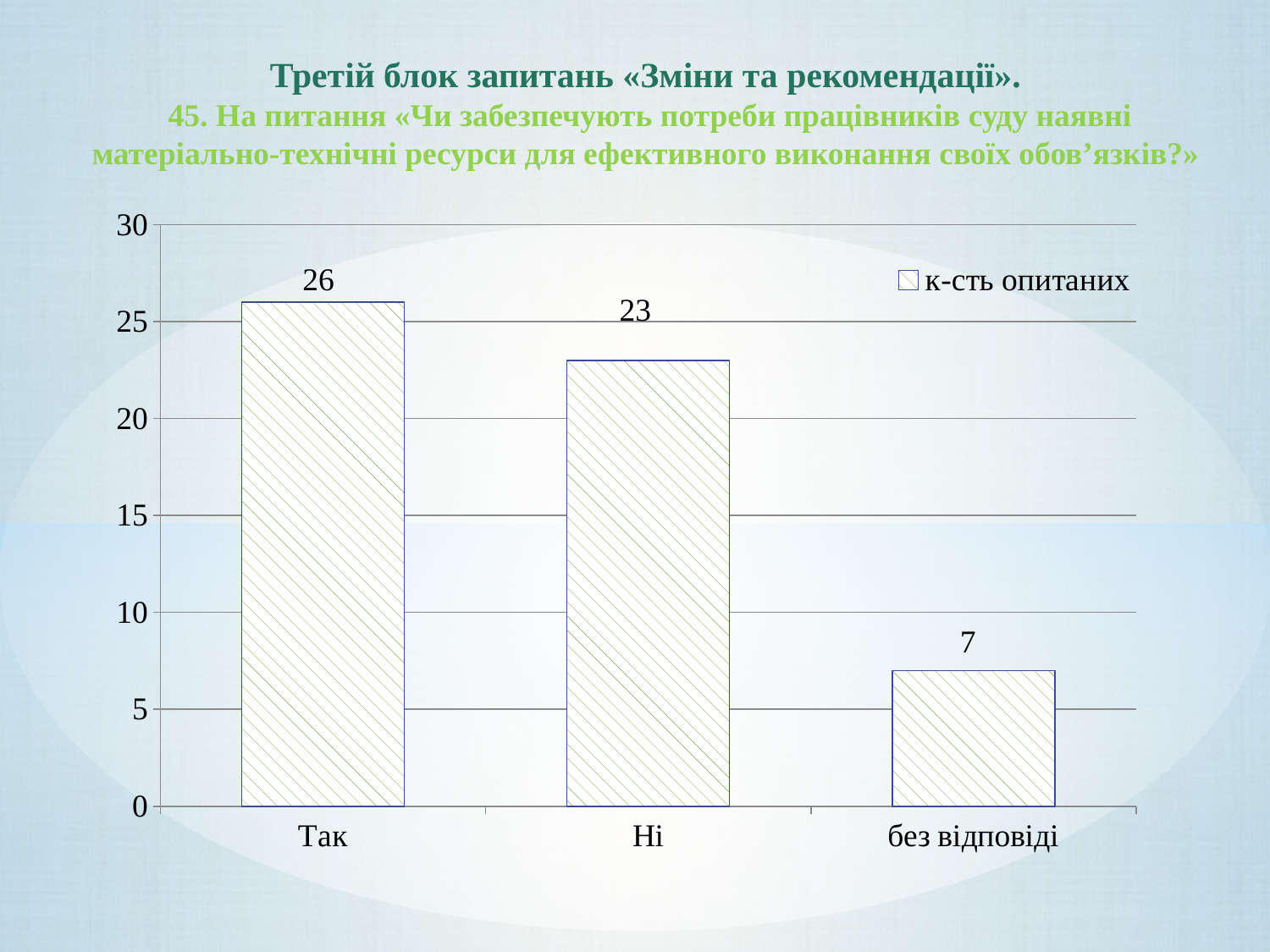
What is the value for "Так"? 26 What is the difference between the values for "Так" and "Ні"? 3 What is the value for "без відповіді"? 7 What is the difference between the values for "Ні" and "без відповіді"? 16 Which category has the highest value? Так How many categories are shown on the x axis? 3 What is the series name shown in the legend? к-сть опитаних Which is larger, the value for "Так" or the value for "без відповіді"? Так Which category has the lowest value? без відповіді What kind of chart is shown on the slide? bar chart Is the value for "Ні" greater or less than 20? greater What is the value for "Ні"? 23